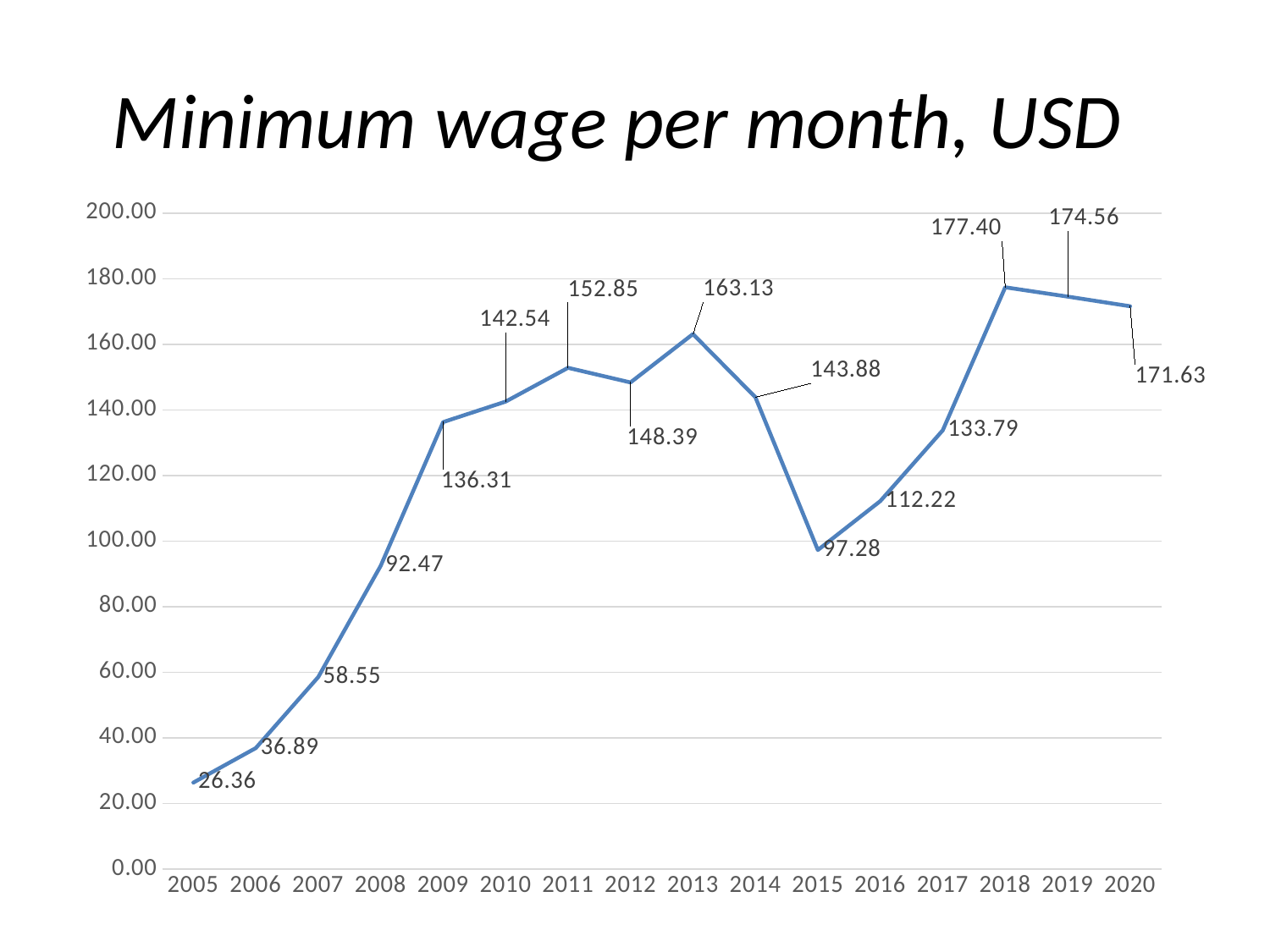
Which year has the highest minimum wage per month? 2018 Do the values rise or fall from 2005 to 2009? rise What is the title of the chart? Minimum wage per month, USD Which year has the lowest minimum wage per month? 2005 What is the value shown for 2015? 97.28 What is the value shown for 2020? 171.63 What is the difference between the values for 2018 and 2015? 80.12 What is the minimum wage per month in 2009? 136.31 Which is larger, the value for 2013 or the value for 2011? 2013 What kind of chart is shown on the slide? line chart How many years are plotted on the x axis? 16 Is the value for 2017 greater or less than 120.00? greater